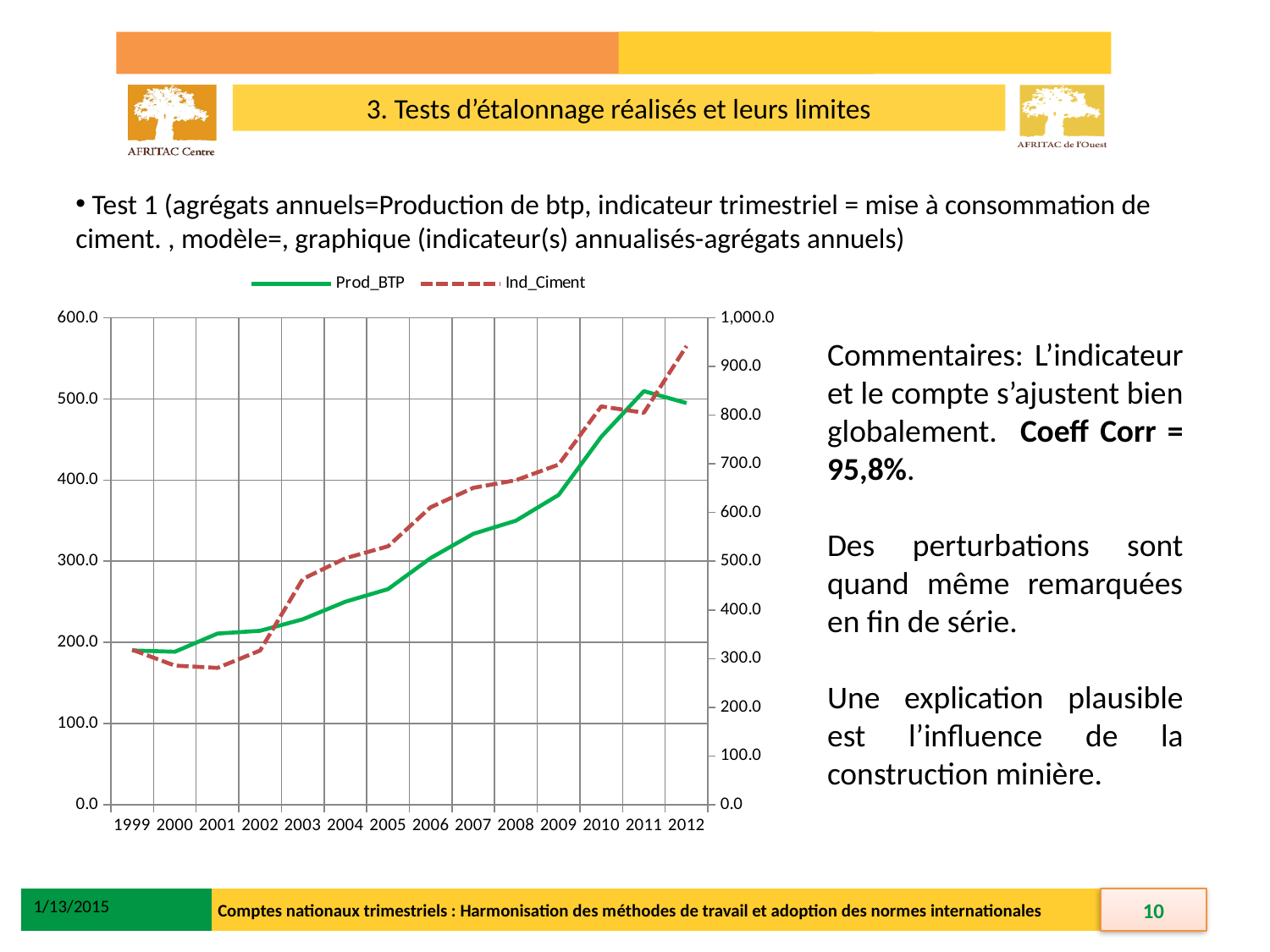
Is the Prod_BTP value for 2008 greater or less than 300.0 on the left axis? greater Is the Ind_Ciment value for 2007 greater or less than 600.0 on the right axis? greater Does the Ind_Ciment series generally rise or fall from 1999 to 2012? rise How many years are shown along the x axis of the chart? 14 Is the Ind_Ciment value for 2003 greater or less than 500.0 on the right axis? less Which series is drawn with a dashed line? Ind_Ciment What are the two series named in the chart legend? Prod_BTP and Ind_Ciment In which year is the Ind_Ciment series at its lowest? 2001 What kind of chart is shown on the slide? line chart Does the Prod_BTP series rise or fall between 2011 and 2012? fall How many series does the chart legend list? 2